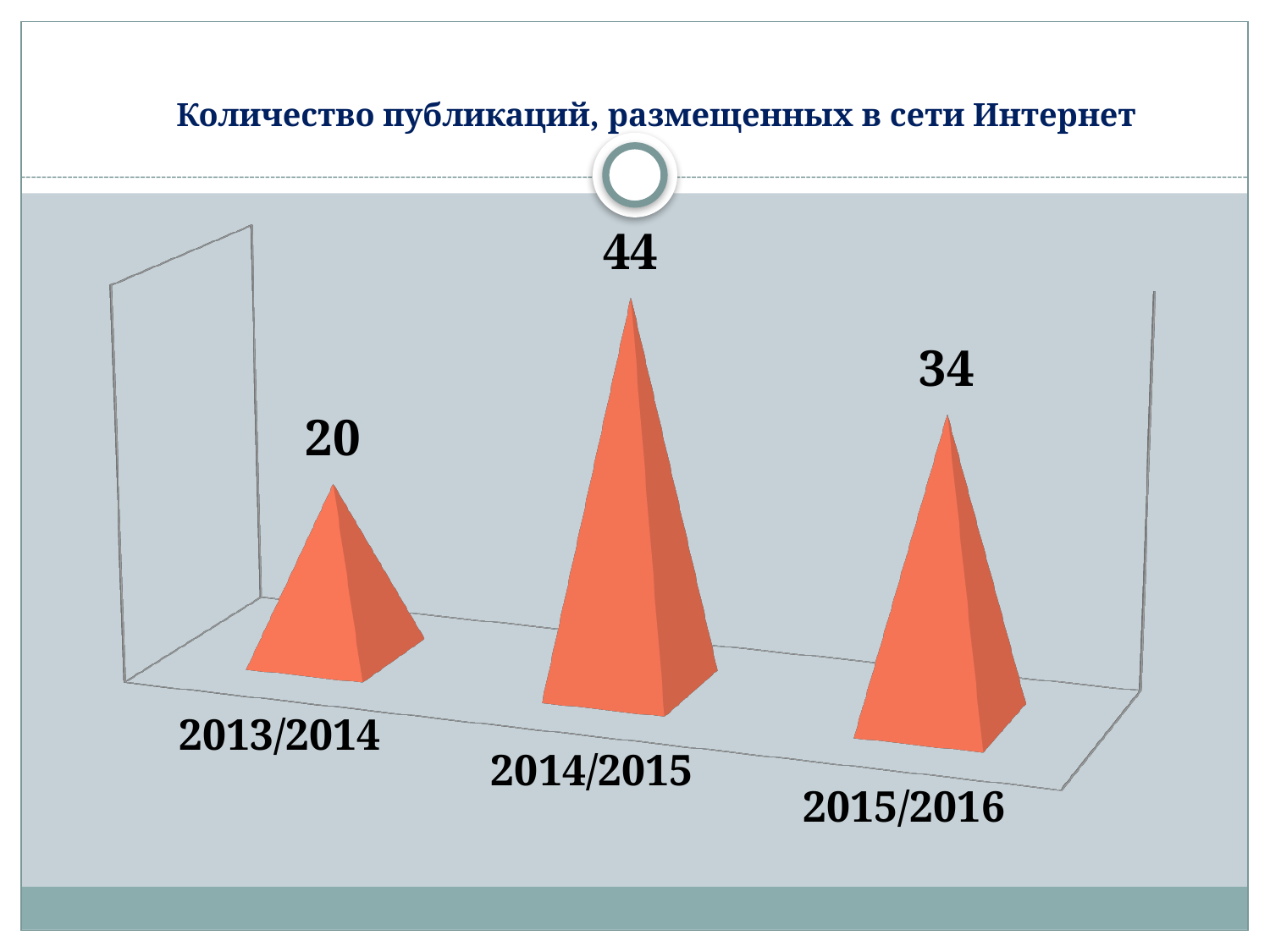
What kind of chart is shown on the slide? bar chart What is the value for 2013/2014? 20 What is the value for 2014/2015? 44 Which category has the highest value? 2014/2015 Which category has the lowest value? 2013/2014 What is the difference between the values for 2014/2015 and 2013/2014? 24 What is the title of the chart? Количество публикаций, размещенных в сети Интернет Which is larger, the value for 2015/2016 or the value for 2013/2014? 2015/2016 Does the value rise or fall from 2014/2015 to 2015/2016? fall What is the value for 2015/2016? 34 What is the difference between the values for 2014/2015 and 2015/2016? 10 How many categories are shown on the chart? 3